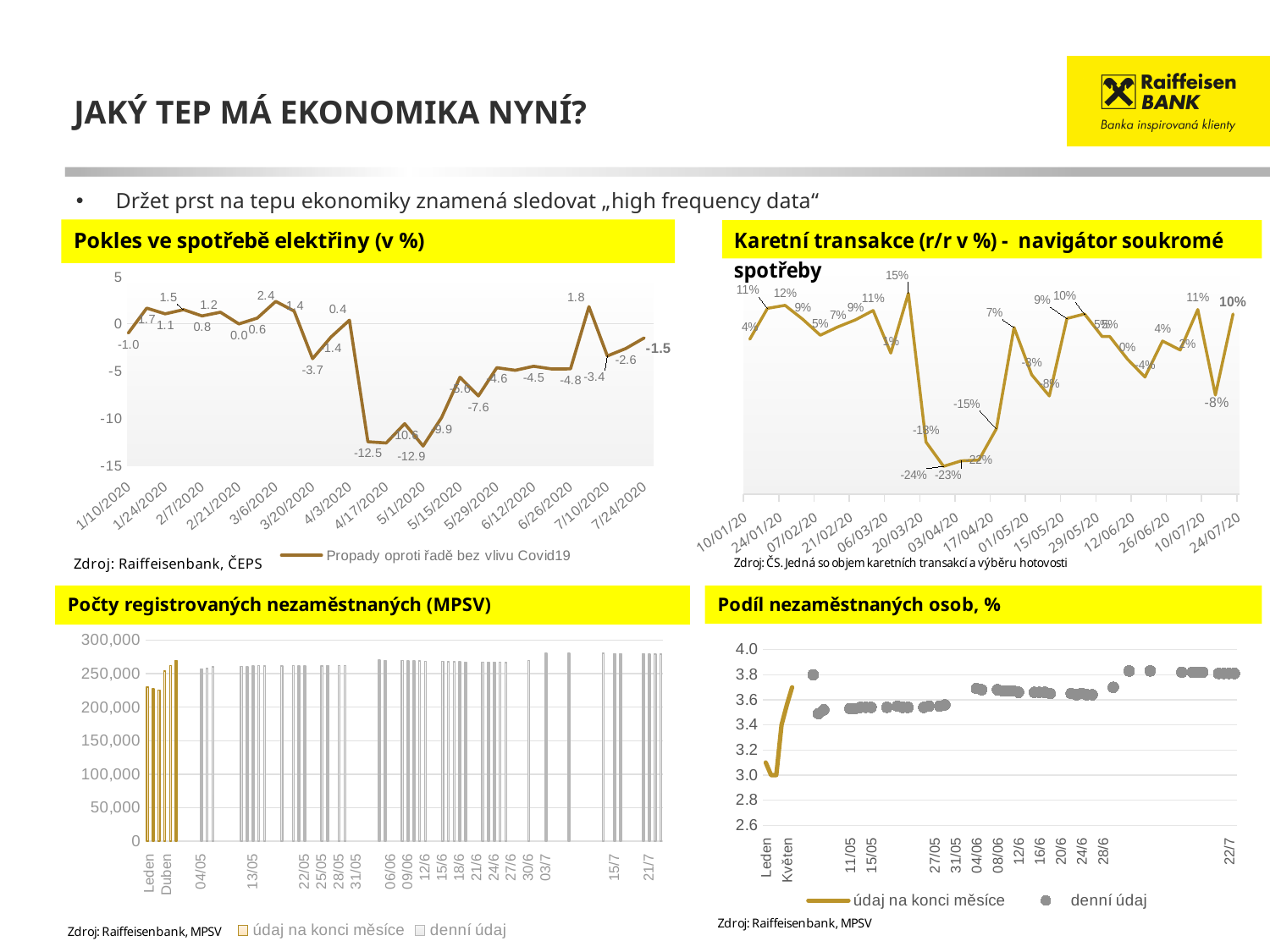
In the chart 'Karetní transakce (r/r v %)', what is the highest value shown? 15% In the chart 'Pokles ve spotřebě elektřiny (v %)', what is the lowest value shown? -12.9 In the chart 'Podíl nezaměstnaných osob, %', is the value for 22/7 greater or less than 3.6? greater What is the legend entry of the chart 'Pokles ve spotřebě elektřiny (v %)'? Propady oproti řadě bez vlivu Covid19 In the chart 'Karetní transakce (r/r v %)', what is the last (bold) value at the right end of the line? 10% How many series does the legend of the chart 'Počty registrovaných nezaměstnaných (MPSV)' list? 2 In the chart 'Pokles ve spotřebě elektřiny (v %)', what is the highest value shown? 2.4 In the chart 'Pokles ve spotřebě elektřiny (v %)', what is the last (bold) value at the right end of the line? -1.5 In the chart 'Karetní transakce (r/r v %)', what is the difference between the highest value (15%) and the lowest value (-24%)? 39 percentage points In the chart 'Karetní transakce (r/r v %)', what is the lowest value shown? -24% What kind of chart is 'Pokles ve spotřebě elektřiny (v %)'? line chart In the chart 'Podíl nezaměstnaných osob, %', is the value for Leden greater or less than 3.4? less